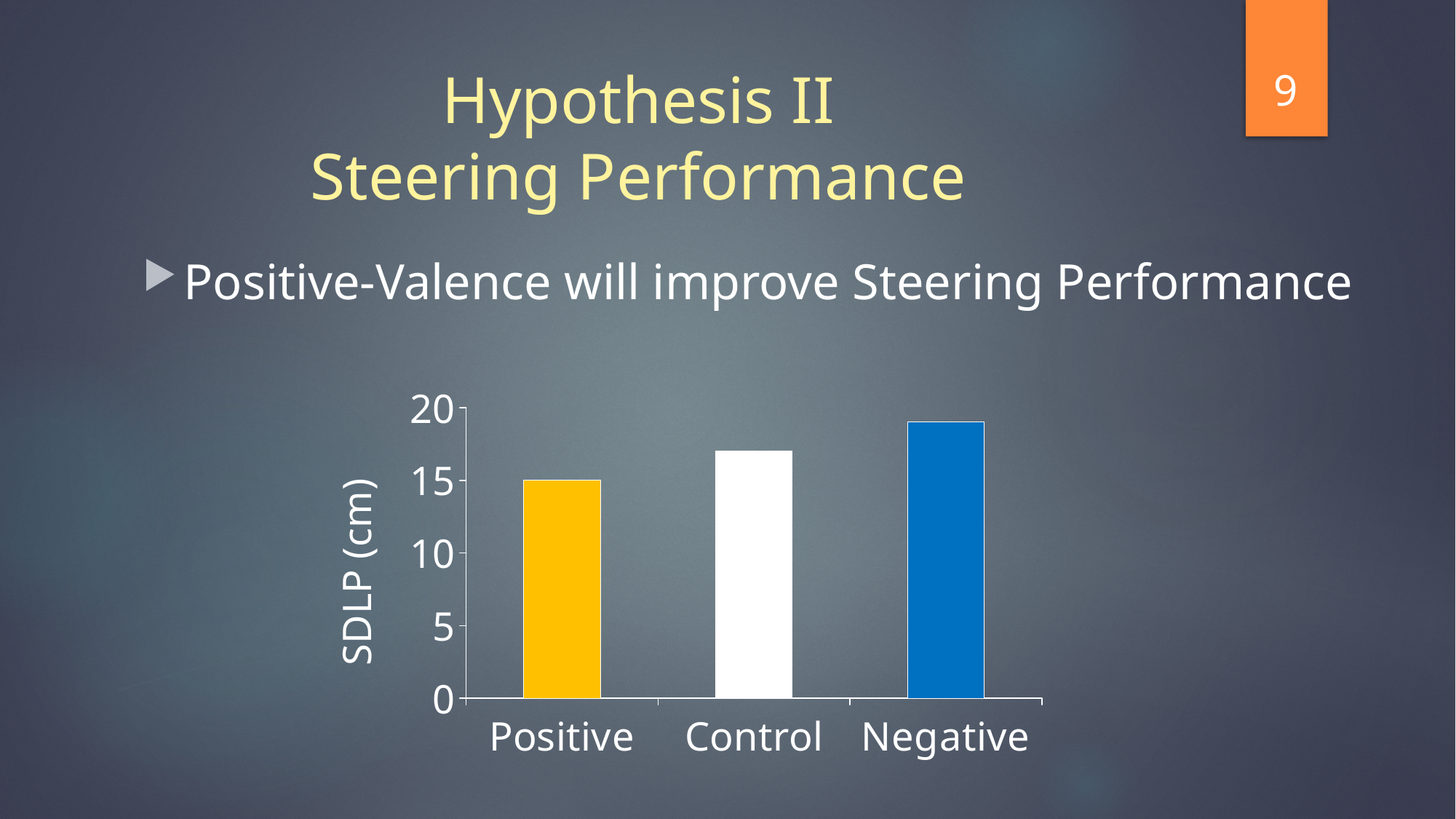
Is the value for Control greater or less than 20? less What kind of chart is shown on the slide? bar chart What is the SDLP (cm) value for Positive? 15 Do the bar values rise or fall from Positive to Negative along the x axis? rise Is the value for Control greater or less than 15? greater Which category has the highest SDLP value? Negative Is the value for Negative greater or less than 20? less How many categories are shown on the x axis of the chart? 3 Which category has the lowest SDLP value? Positive Which is larger, the value for Control or the value for Negative? Negative What colour is the bar for Negative? blue What is the label on the y axis of the chart? SDLP (cm)